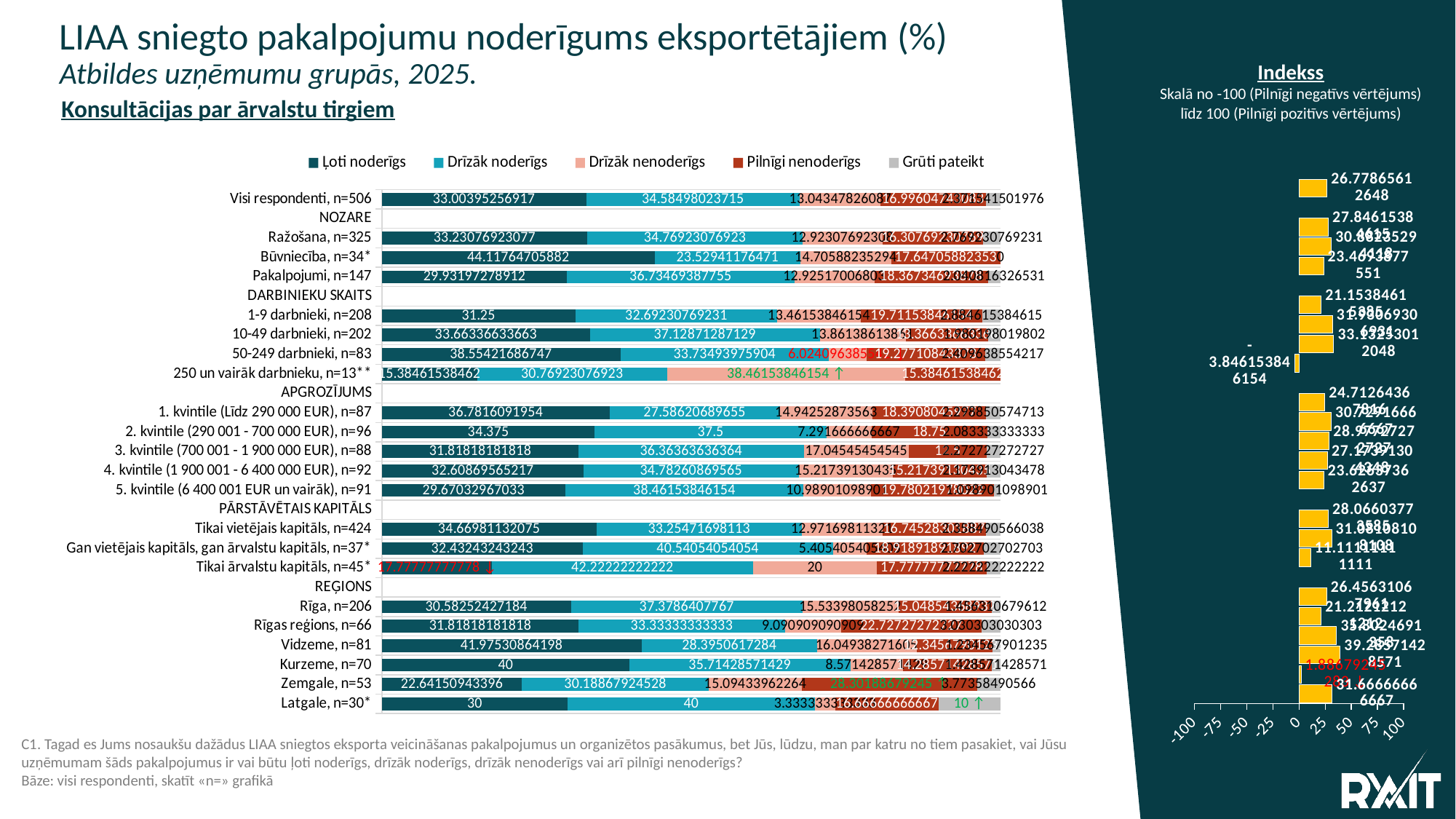
In the stacked bar chart, what is the 'Drīzāk noderīgs' value for Latgale, n=30*? 40 In the stacked bar chart, what is the 'Drīzāk nenoderīgs' value for 250 un vairāk darbinieku, n=13**? 38.46153846154 In the stacked bar chart, what is the 'Ļoti noderīgs' value for Būvniecība, n=34*? 44.11764705882 How many series does the legend of the stacked bar chart list? 5 In the stacked bar chart, what is the 'Ļoti noderīgs' value for Kurzeme, n=70? 40 In the Indekss chart on the right, is the index value for 250 un vairāk darbinieku, n=13** greater or less than 0? less In the stacked bar chart, which respondent group has the lowest 'Ļoti noderīgs' value? 250 un vairāk darbinieku, n=13** What kind of chart is the main chart on the left of the slide? Stacked horizontal bar chart In the stacked bar chart, for Būvniecība, n=34*, which is larger: 'Ļoti noderīgs' or 'Drīzāk noderīgs'? Ļoti noderīgs In the stacked bar chart, what is the difference between the 'Ļoti noderīgs' values for Kurzeme, n=70 and Latgale, n=30*? 10 In the stacked bar chart, what is the 'Drīzāk noderīgs' value for 2. kvintile (290 001 - 700 000 EUR), n=96? 37.5 In the stacked bar chart, which respondent group has the highest 'Ļoti noderīgs' value? Būvniecība, n=34*